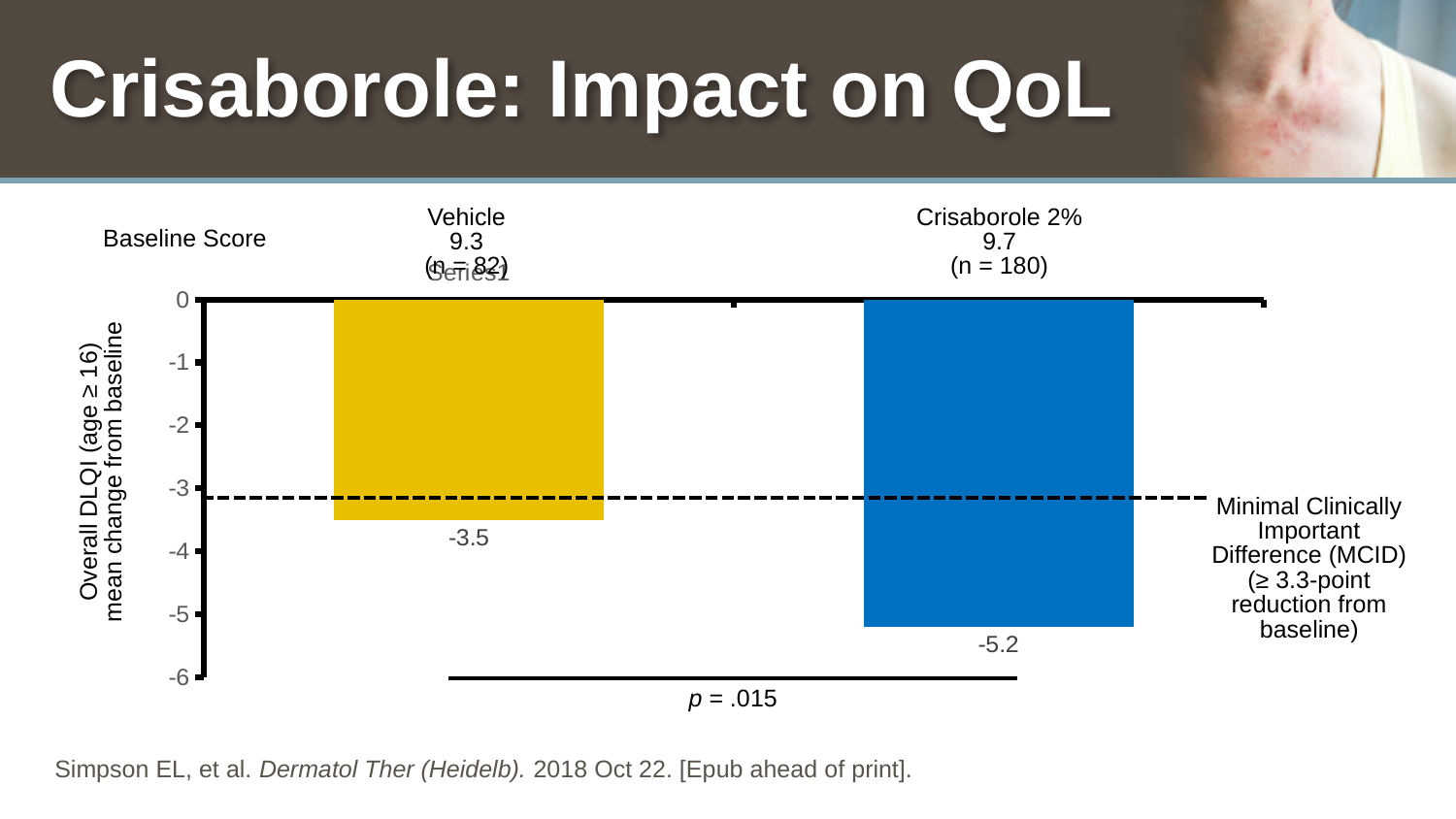
What is the difference between the Crisaborole 2% and Vehicle mean changes from baseline? 1.7 Which bar has the lowest (most negative) value on the chart? Crisaborole 2% What p-value is shown for the comparison between the two groups? p = .015 How many bars are plotted on the chart? 2 What is the mean change from baseline in overall DLQI for the Vehicle group? -3.5 What is the mean change from baseline in overall DLQI for the Crisaborole 2% group? -5.2 What is the baseline score for the Vehicle group? 9.3 How many patients were in the Crisaborole 2% group? 180 What is the baseline score for the Crisaborole 2% group? 9.7 Which group shows the larger reduction in overall DLQI from baseline? Crisaborole 2% What type of chart is shown on the slide? Bar chart What reduction from baseline does the dashed line labelled Minimal Clinically Important Difference (MCID) represent? ≥ 3.3-point reduction from baseline